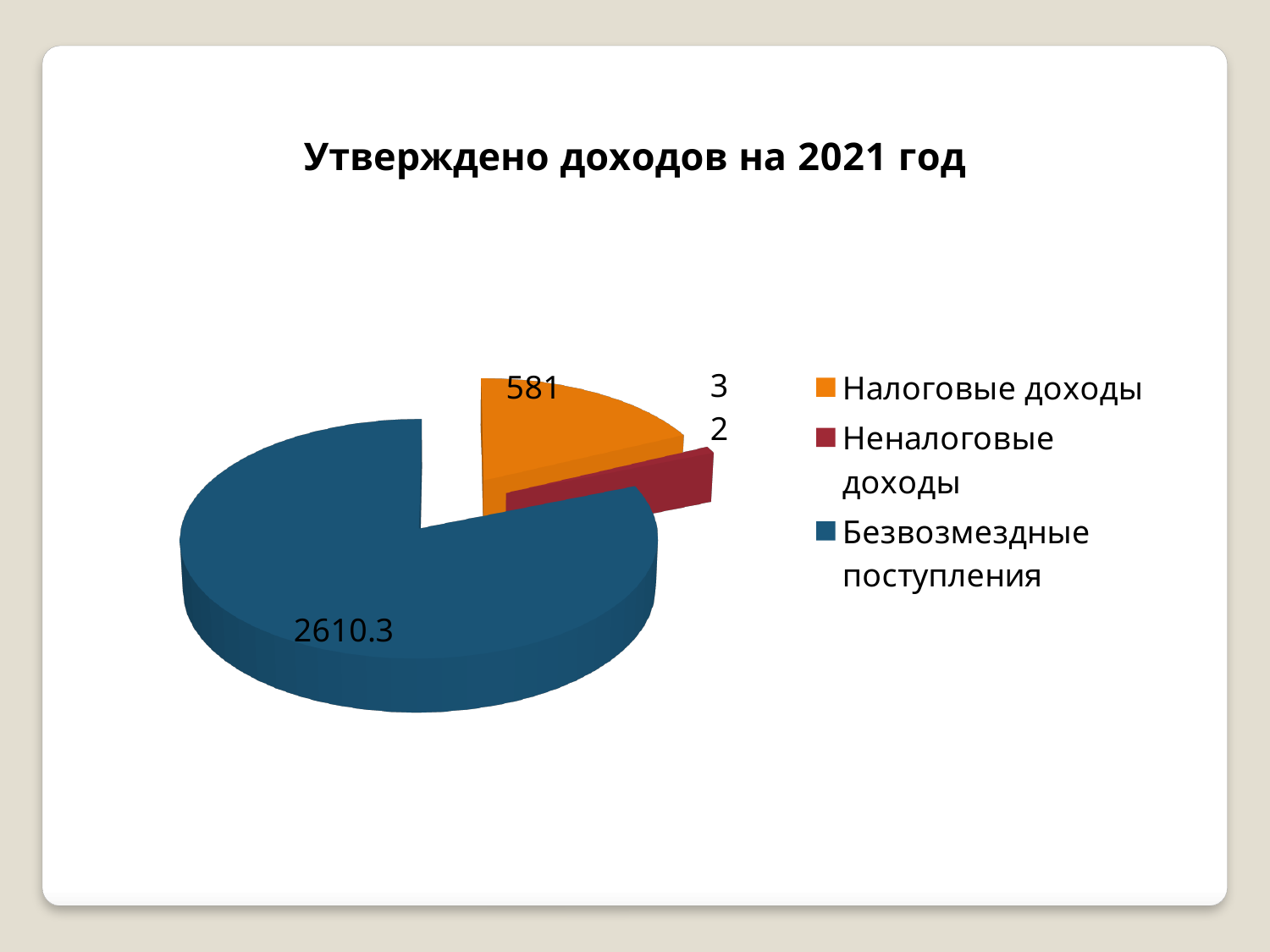
What type of chart is shown on the slide? Pie chart Which is larger: Налоговые доходы or Безвозмездные поступления? Безвозмездные поступления What is the value for Безвозмездные поступления? 2610.3 What colour is the slice for Налоговые доходы? Orange How many categories are shown in the pie chart? 3 What is the difference between Безвозмездные поступления and Налоговые доходы? 2029.3 Which category has the smallest slice of the pie? Неналоговые доходы How many entries does the legend list? 3 What is the value for Налоговые доходы? 581 What is the title of the chart? Утверждено доходов на 2021 год Which category has the largest slice of the pie? Безвозмездные поступления Which is larger: Налоговые доходы or Неналоговые доходы? Налоговые доходы